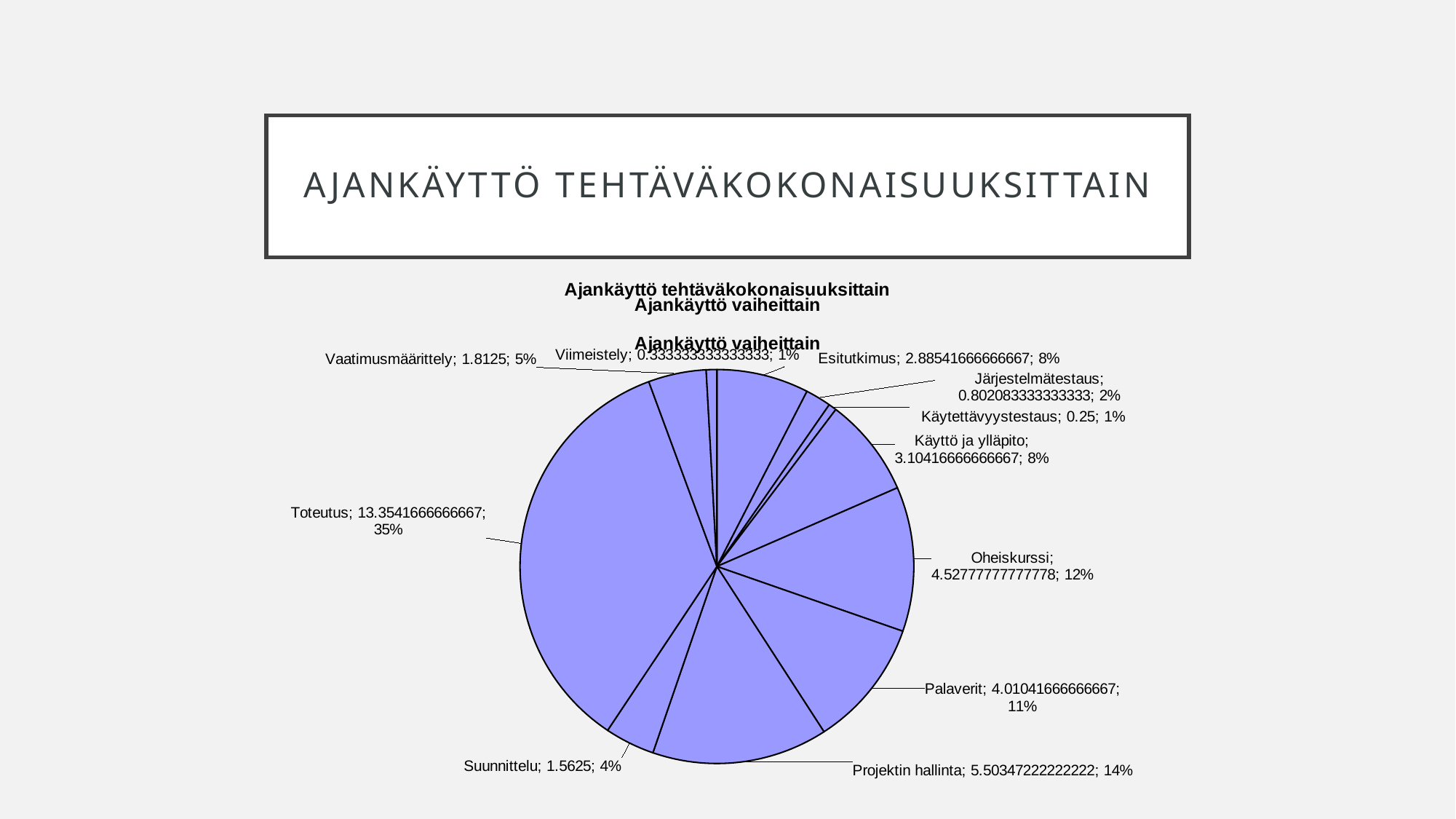
What is the value for Käytettävyystestaus? 0.25 What is the value for Projektin hallinta? 5.50347222222222 Which category has the smallest value in the pie chart? Käytettävyystestaus What share of the pie does Toteutus represent? 35% What share of the pie does Oheiskurssi represent? 12% How many slices does the pie chart have? 11 Which is larger, the value for Palaverit or the value for Oheiskurssi? Oheiskurssi What kind of chart is shown on the slide? pie chart What is the value for Toteutus? 13.3541666666667 What is the difference between the values for Vaatimusmäärittely and Suunnittelu? 0.25 Which category has the largest slice of the pie? Toteutus What share of the pie does Palaverit represent? 11%